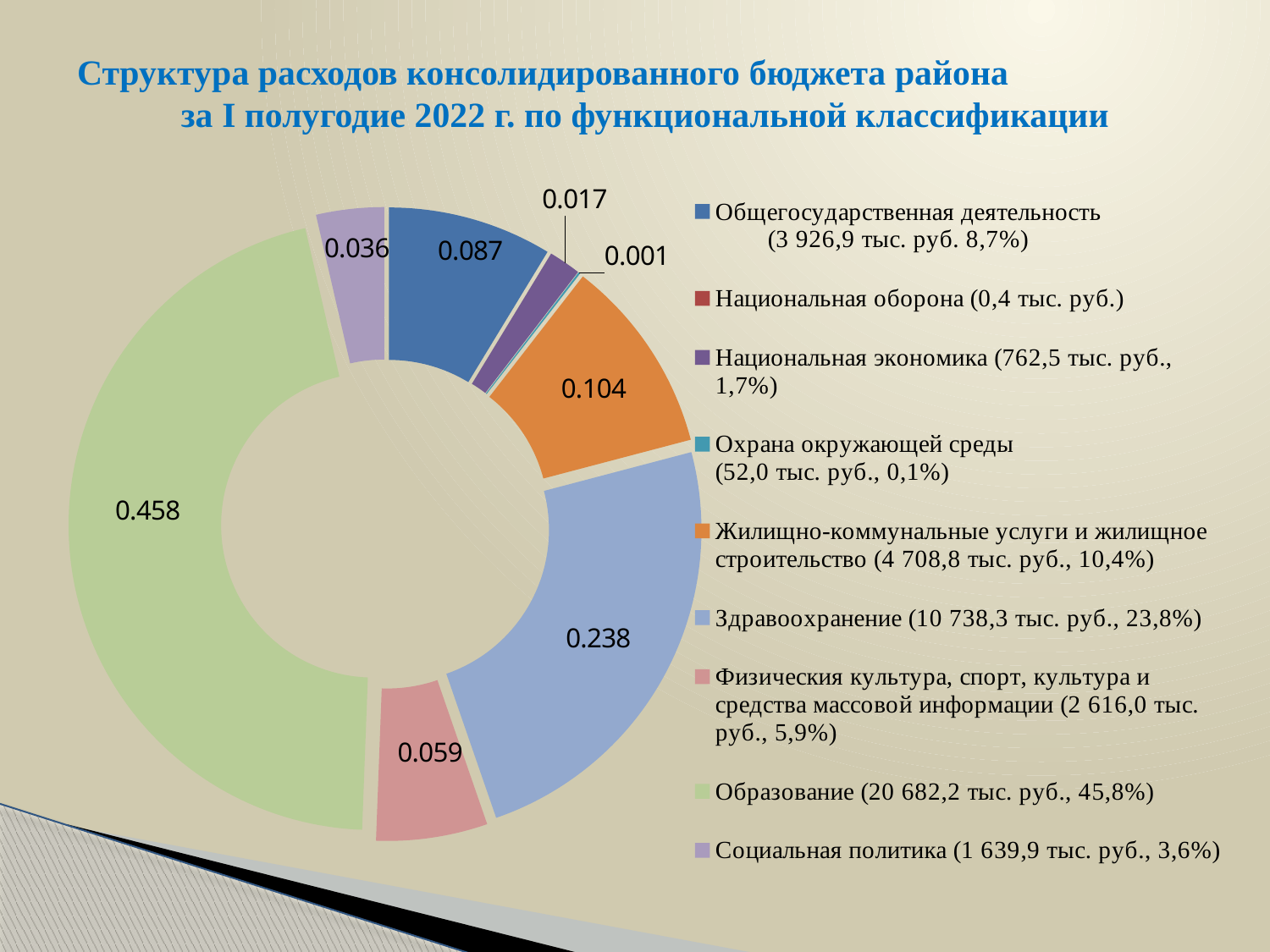
According to the legend, what amount in тыс. руб. is given for Здравоохранение? 10 738,3 тыс. руб. What value is labelled on the slice for Здравоохранение? 0.238 What value is labelled on the slice for Образование? 0.458 How many categories does the legend list? 9 What kind of chart is shown on the slide? Doughnut (pie) chart What is the difference between the labelled values for Образование and Здравоохранение? 0.220 What value is labelled on the slice for Социальная политика? 0.036 Which category has the largest slice of the chart? Образование What value is labelled on the slice for Общегосударственная деятельность? 0.087 Which labelled slice has the smallest value on the chart? Охрана окружающей среды (0.001) What value is labelled on the slice for Жилищно-коммунальные услуги и жилищное строительство? 0.104 Which slice is larger: Жилищно-коммунальные услуги и жилищное строительство or Общегосударственная деятельность? Жилищно-коммунальные услуги и жилищное строительство